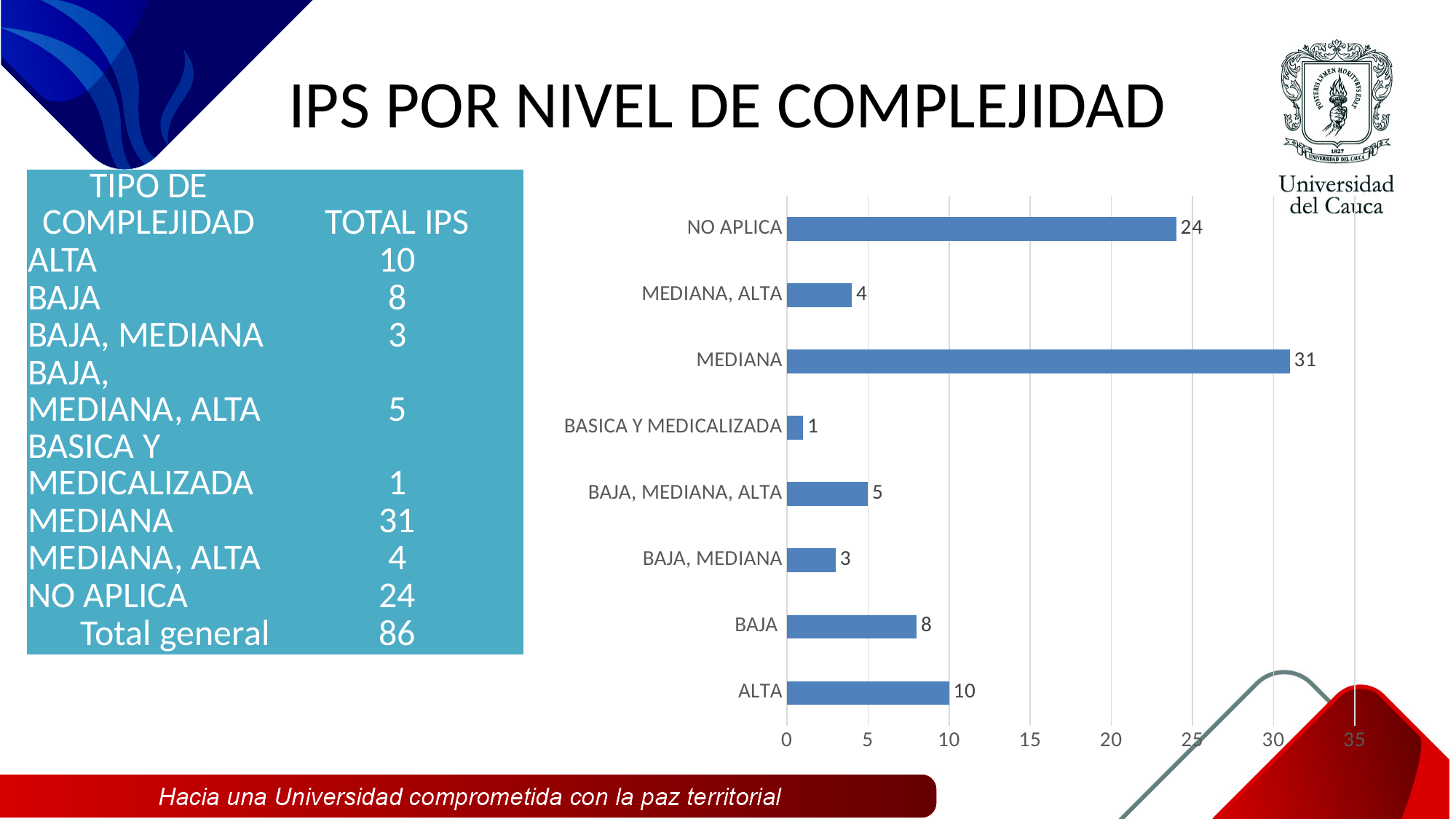
What is the value for BAJA, MEDIANA, ALTA in the bar chart? 5 How many categories are shown in the bar chart? 8 Which category has the lowest value in the bar chart? BASICA Y MEDICALIZADA What is the difference between the values for ALTA and BAJA? 2 What is the title of the slide containing the chart? IPS POR NIVEL DE COMPLEJIDAD What is the value for NO APLICA in the bar chart? 24 Which category has the highest value in the bar chart? MEDIANA Is the value for NO APLICA greater or less than 20? greater What is the value for MEDIANA in the bar chart? 31 What kind of chart is shown on the slide? bar chart What is the difference between the values for MEDIANA and NO APLICA? 7 Which is larger, the value for BAJA or the value for MEDIANA, ALTA? BAJA